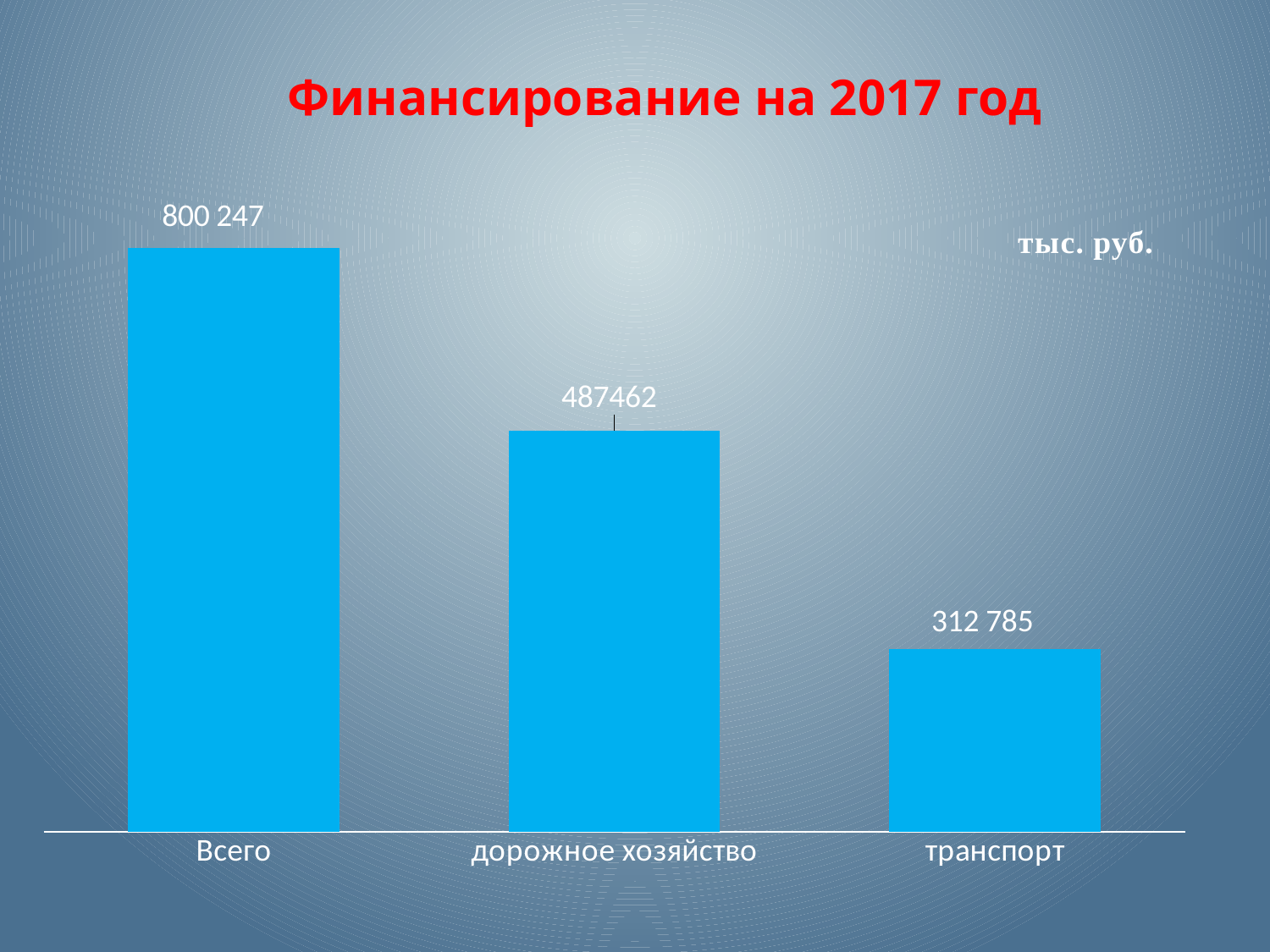
Which is larger, the value for дорожное хозяйство or the value for транспорт? дорожное хозяйство Which category has the lowest value? транспорт Which category has the highest value? Всего What is the value for дорожное хозяйство? 487462 What kind of chart is shown on the slide? bar chart What is the difference between the values for дорожное хозяйство and транспорт? 174 677 What is the difference between the values for Всего and дорожное хозяйство? 312 785 What is the value for Всего? 800 247 Do the values rise or fall from left to right along the x axis? fall How many categories are shown in the chart? 3 What is the value for транспорт? 312 785